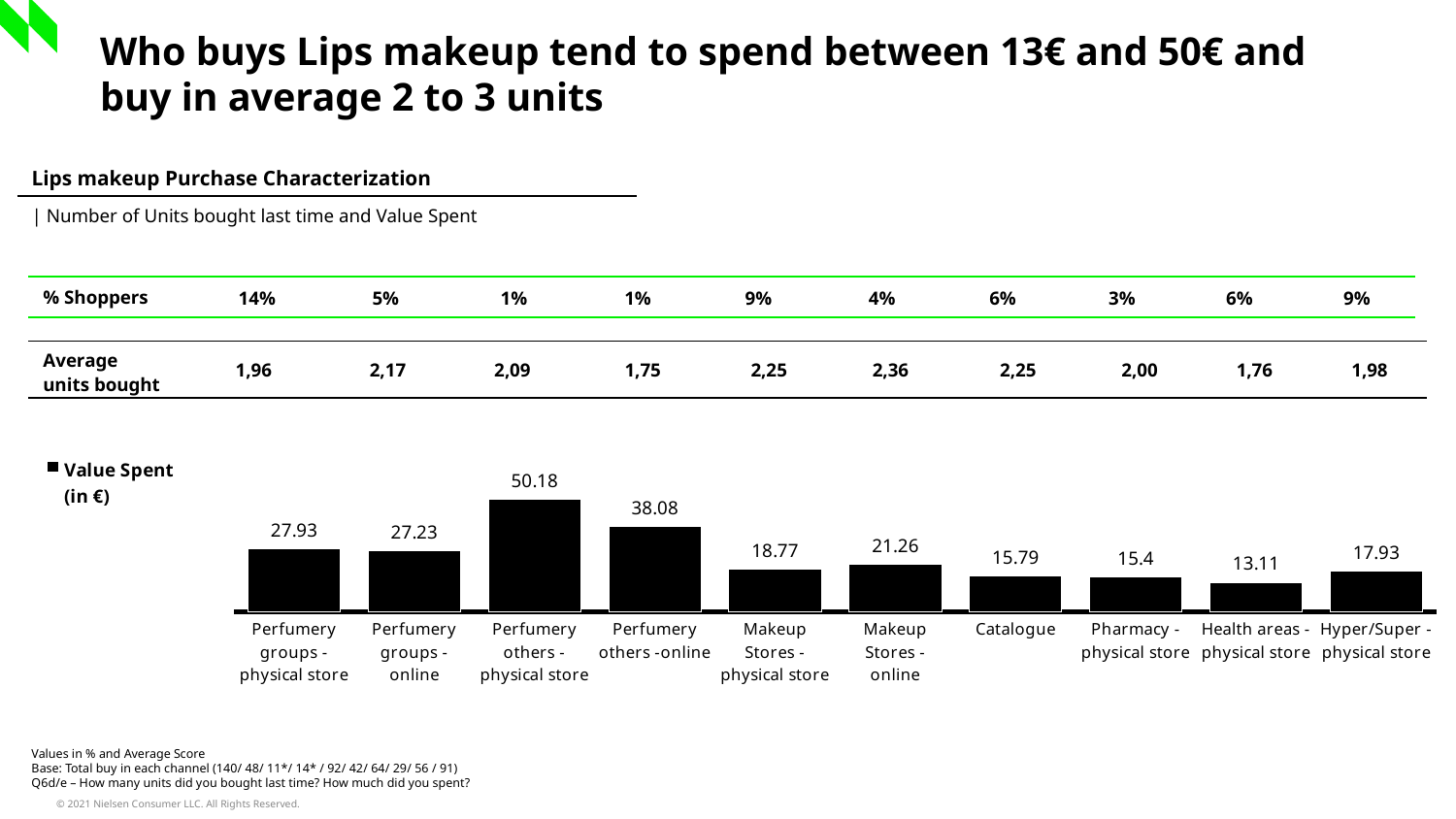
How many series does the legend of the Value Spent chart list? 1 What is the difference in value spent between Makeup Stores - online and Makeup Stores - physical store? 2.49 What is the value spent for Health areas - physical store? 13.11 Which channel has the highest value spent? Perfumery others - physical store How many channels are shown in the Value Spent chart? 10 What kind of chart is used to show Value Spent? bar chart What is the value spent for Makeup Stores - online? 21.26 Which channel has the lowest value spent? Health areas - physical store Which has a larger value spent, Perfumery groups - physical store or Perfumery groups - online? Perfumery groups - physical store What is the value spent for Catalogue? 15.79 What is the difference in value spent between Perfumery others - physical store and Perfumery others - online? 12.10 What is the value spent for Perfumery others - physical store? 50.18